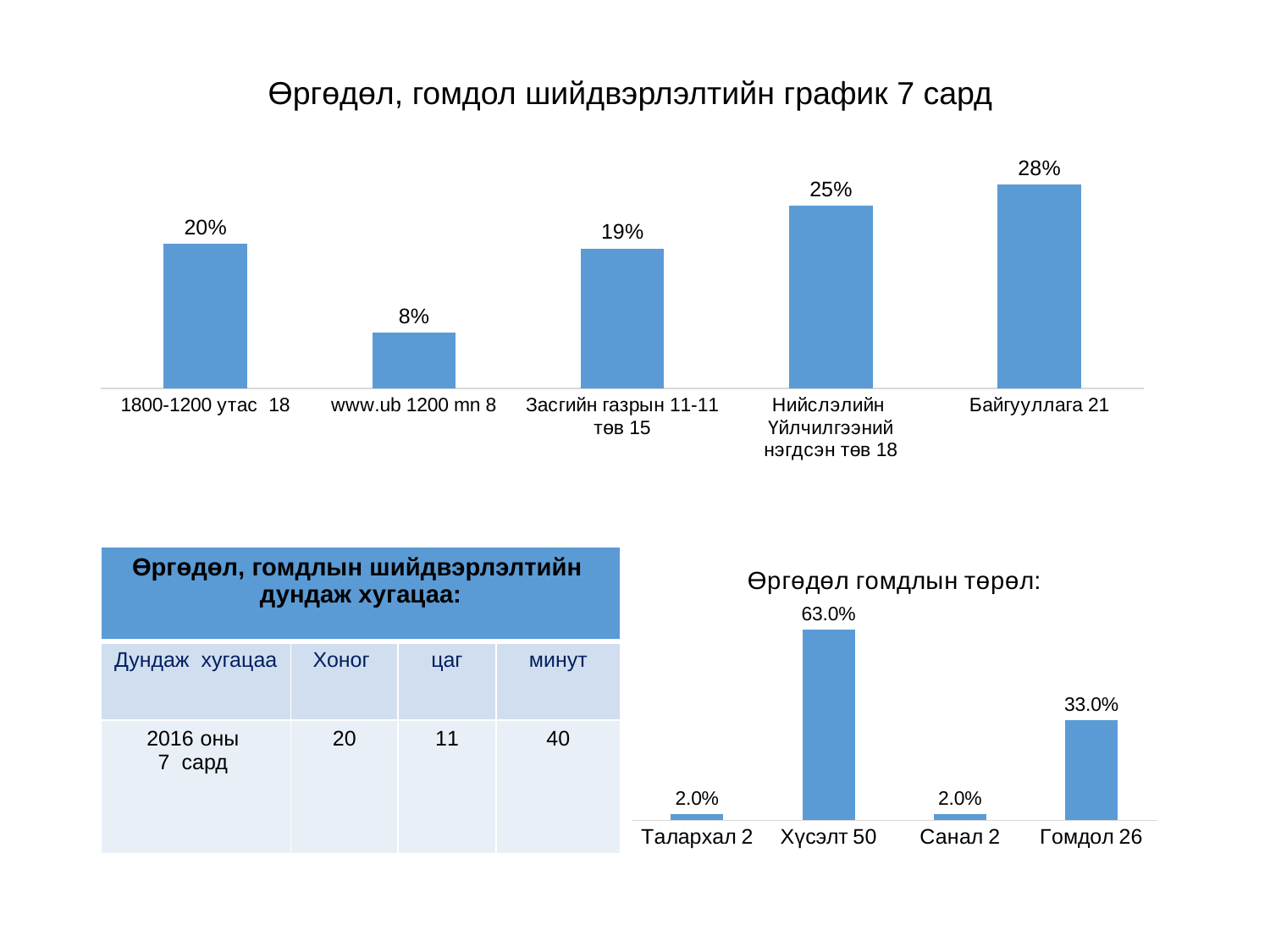
In the top chart, what is the difference between the values for Нийслэлийн Үйлчилгээний нэгдсэн төв 18 and Засгийн газрын 11-11 төв 15? 6% How many categories are shown in the top chart? 5 In the top chart, which category has the lowest value? www.ub 1200 mn 8 How many categories are shown in the chart titled Өргөдөл гомдлын төрөл? 4 What kind of chart is the top chart? bar chart In the chart titled Өргөдөл гомдлын төрөл, what is the value for Гомдол 26? 33.0% In the chart titled Өргөдөл гомдлын төрөл, what is the value for Хүсэлт 50? 63.0% In the chart titled Өргөдөл гомдлын төрөл, which category has the highest value? Хүсэлт 50 In the top chart, which category has the highest value? Байгууллага 21 In the top chart, which is larger: the value for 1800-1200 утас 18 or the value for Засгийн газрын 11-11 төв 15? 1800-1200 утас 18 In the top chart, what is the value for www.ub 1200 mn 8? 8% In the top chart, what is the value for Байгууллага 21? 28%